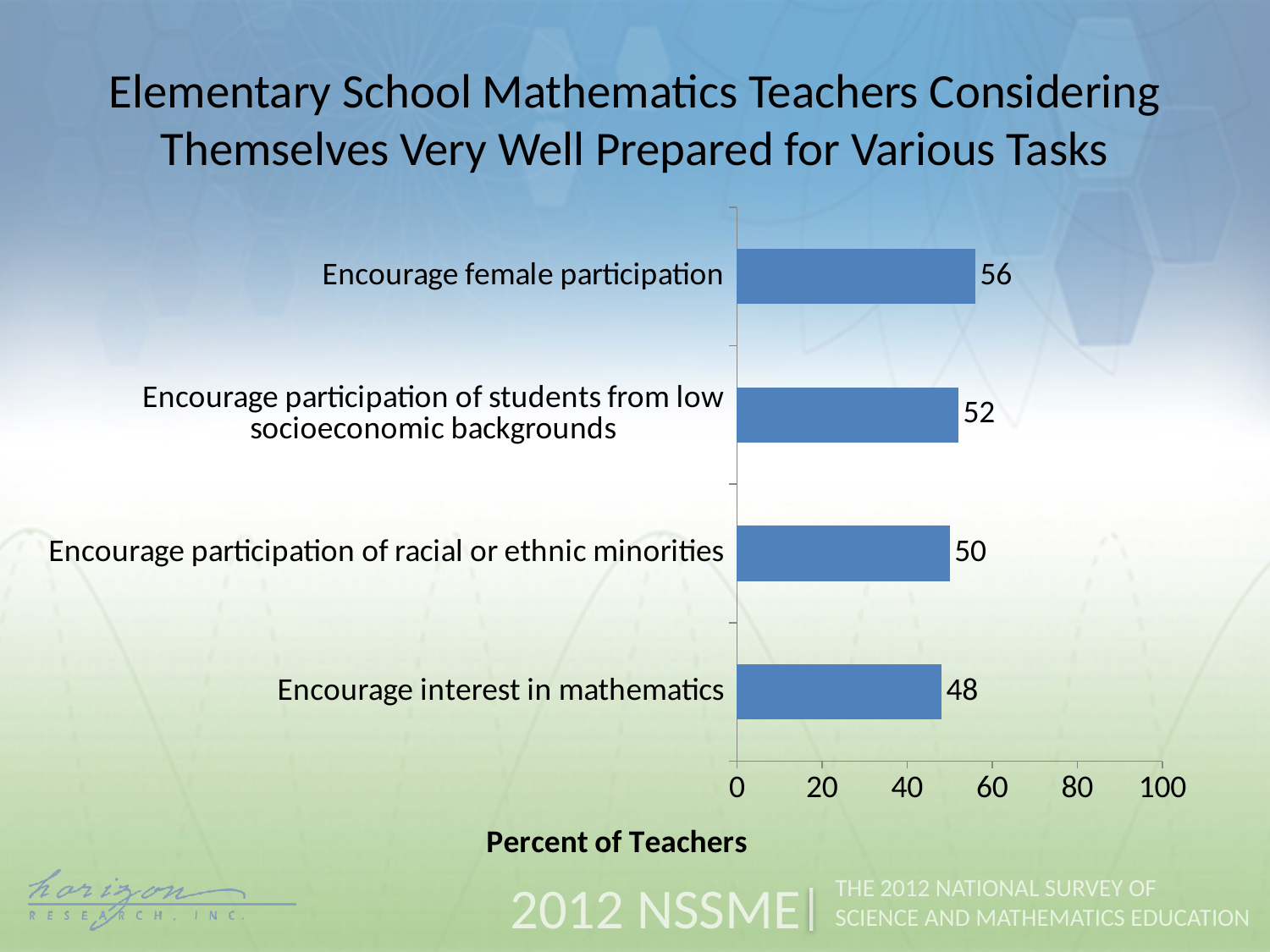
What kind of chart is shown on the slide? Bar chart Which task has the lowest percent of teachers considering themselves very well prepared? Encourage interest in mathematics How many tasks are shown in the chart? 4 What percent of teachers consider themselves very well prepared to encourage female participation? 56 What is the value for 'Encourage participation of racial or ethnic minorities'? 50 What is the value for 'Encourage interest in mathematics'? 48 What is the value for 'Encourage participation of students from low socioeconomic backgrounds'? 52 What is the label of the horizontal axis? Percent of Teachers Which is larger: the value for 'Encourage participation of students from low socioeconomic backgrounds' or 'Encourage participation of racial or ethnic minorities'? Encourage participation of students from low socioeconomic backgrounds Which task has the highest percent of teachers considering themselves very well prepared? Encourage female participation What is the difference between the values for 'Encourage female participation' and 'Encourage interest in mathematics'? 8 Is the value for 'Encourage female participation' greater or less than 60? less